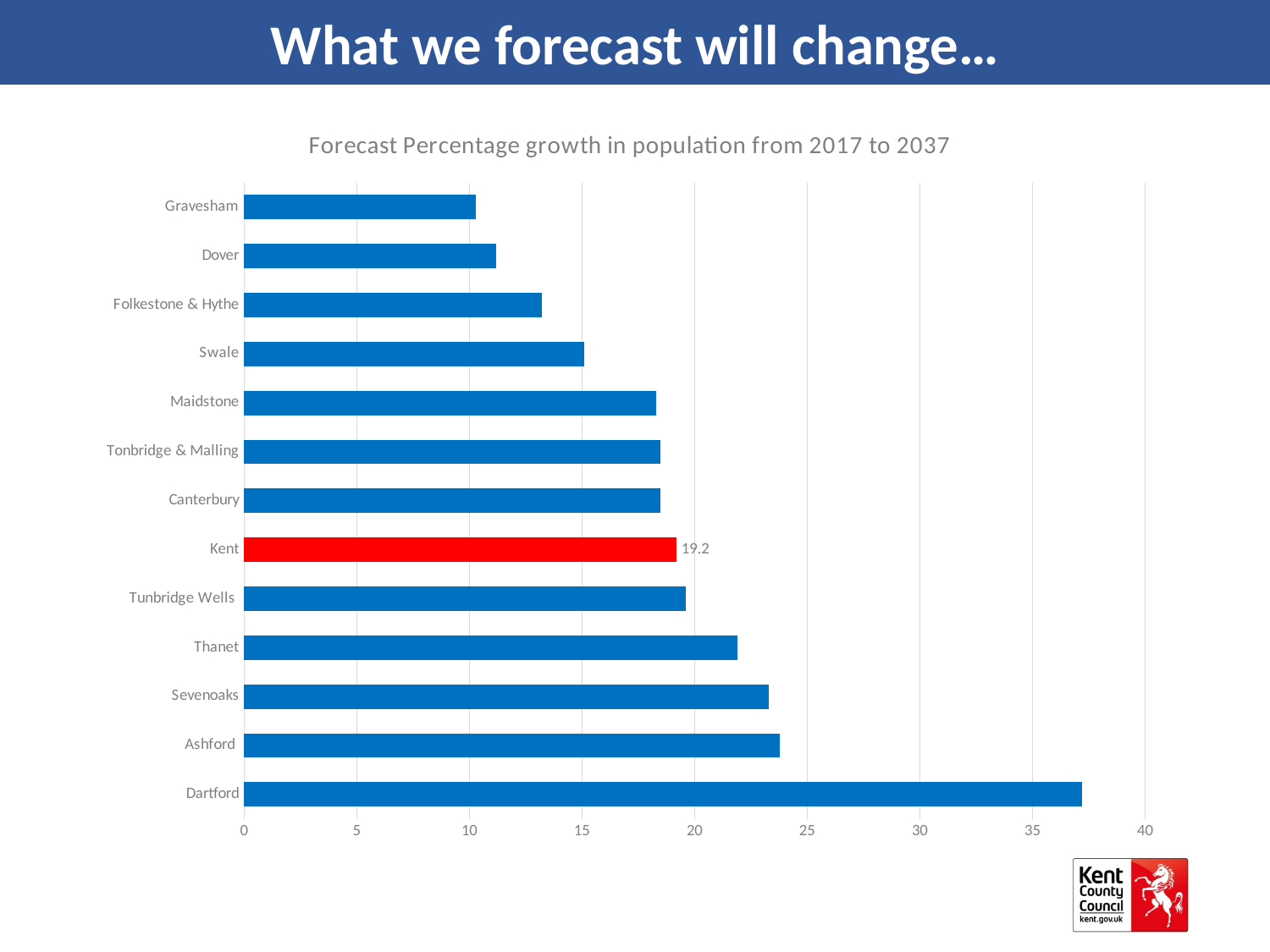
Which area has the lowest forecast percentage growth in population? Gravesham What is the forecast percentage growth in population for Kent? 19.2 Which has a larger forecast growth, Thanet or Tunbridge Wells? Thanet What type of chart is shown on the slide? Bar chart How many areas are shown in the chart? 13 Which bar is coloured red in the chart? Kent Is the value for Dover greater or less than 15? less Which area has the highest forecast percentage growth in population? Dartford Is the value for Ashford greater or less than 25? less Is the value for Thanet greater or less than 20? greater